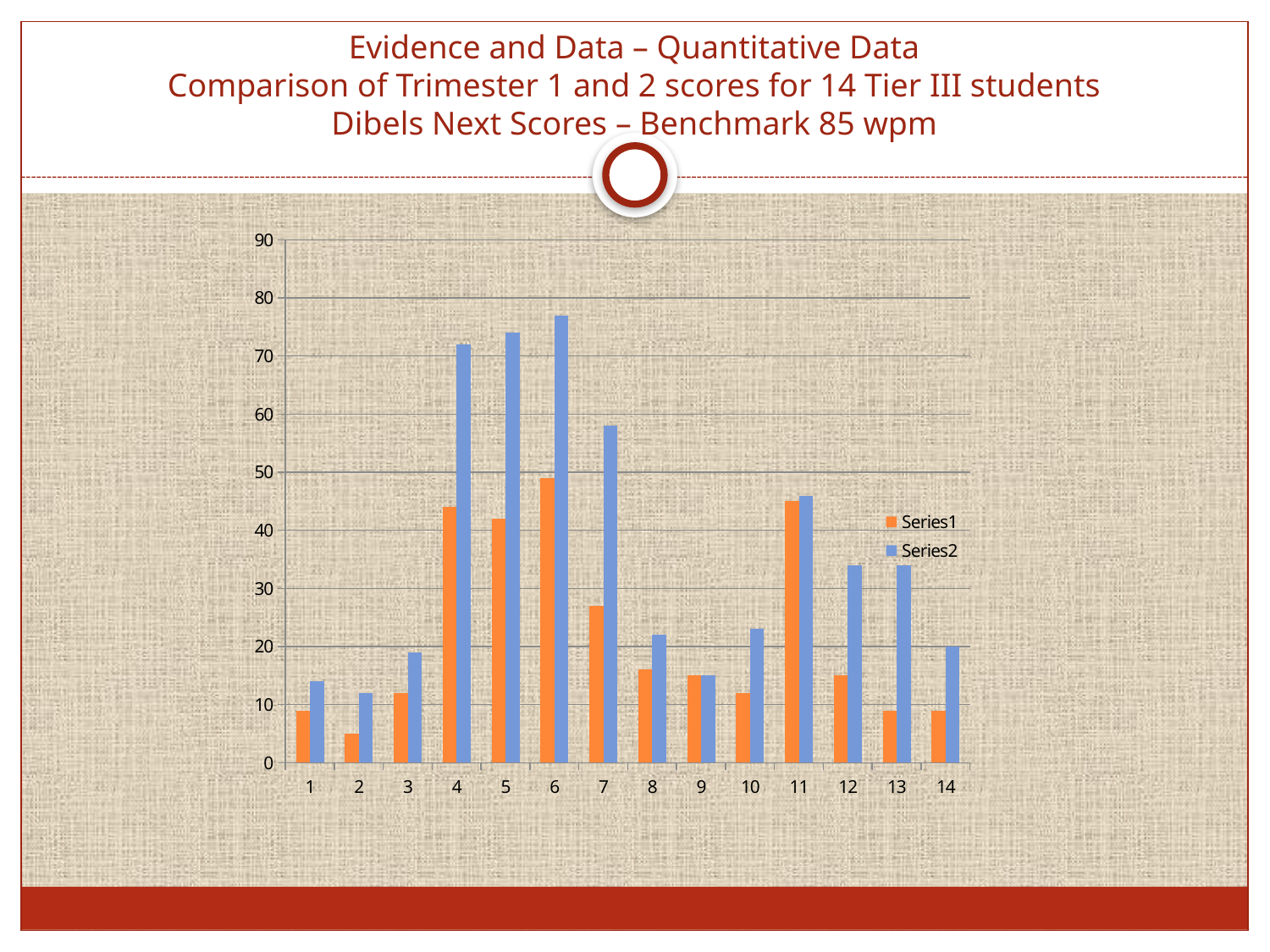
What colour are the Series1 bars? orange Which category has the lowest Series1 value? 2 Which category has the highest Series1 value? 6 How many series does the legend list? 2 Is the Series2 value for category 6 greater or less than 70? greater For category 4, which is larger, Series1 or Series2? Series2 Is the Series1 value for category 7 greater or less than 30? less Is the Series2 value for category 7 greater or less than 50? greater What kind of chart is shown on the slide? bar chart Which category has the highest Series2 value? 6 How many categories are shown on the x axis? 14